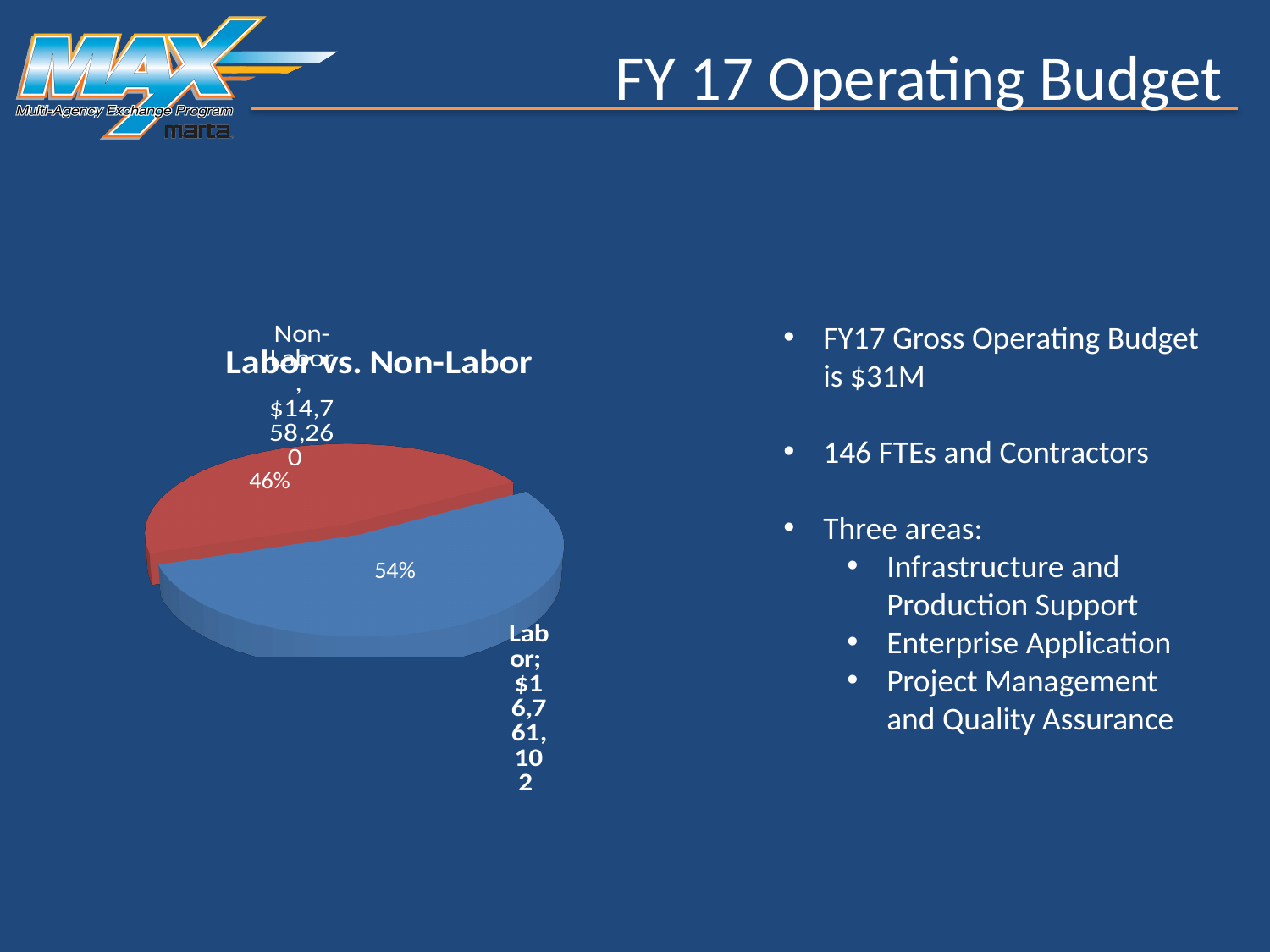
What is the value shown for Labor? $16,761,102 Which category has the largest share of the pie? Labor What colour is the Labor slice? blue What kind of chart is shown on the slide? pie chart Which category has the smallest share of the pie? Non-Labor How many slices does the pie chart have? 2 Which slice is larger, Labor or Non-Labor? Labor What is the difference in percentage points between the Labor and Non-Labor shares? 8 What is the title of the chart? Labor vs. Non-Labor What is the value shown for Non-Labor? $14,758,260 What percentage of the pie does Non-Labor represent? 46% What percentage of the pie does Labor represent? 54%